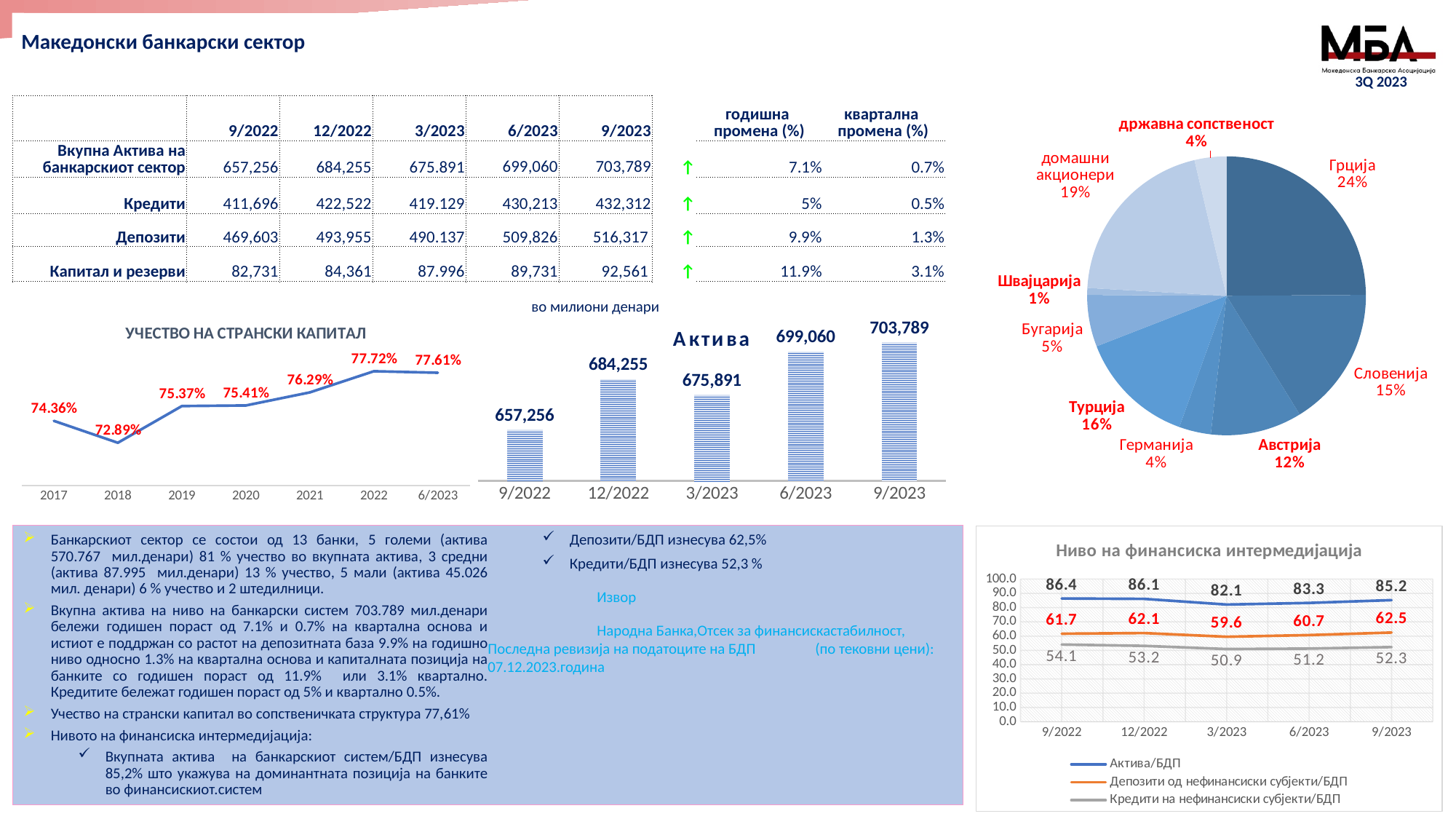
In the bar chart titled 'Актива', what is the difference between the values for 9/2023 and 9/2022? 46,533 In the bar chart titled 'Актива', what is the value for 3/2023? 675,891 What kind of chart is the chart titled 'Актива'? bar chart In the chart titled 'Ниво на финансиска интермедијација', how many series does the legend list? 3 In the chart titled 'УЧЕСТВО НА СТРАНСКИ КАПИТАЛ', how many data points are plotted? 7 In the pie chart on the right of the slide, what share does Грција have? 24% In the chart titled 'УЧЕСТВО НА СТРАНСКИ КАПИТАЛ', which year has the highest value? 2022 In the chart titled 'Ниво на финансиска интермедијација', what is the value of Депозити од нефинансиски субјекти/БДП for 3/2023? 59.6 In the pie chart on the right of the slide, which slice is the smallest? Швајцарија In the chart titled 'УЧЕСТВО НА СТРАНСКИ КАПИТАЛ', what is the value for 2018? 72.89% In the bar chart titled 'Актива', which period has the lowest value? 9/2022 In the pie chart on the right of the slide, how many slices are there? 9